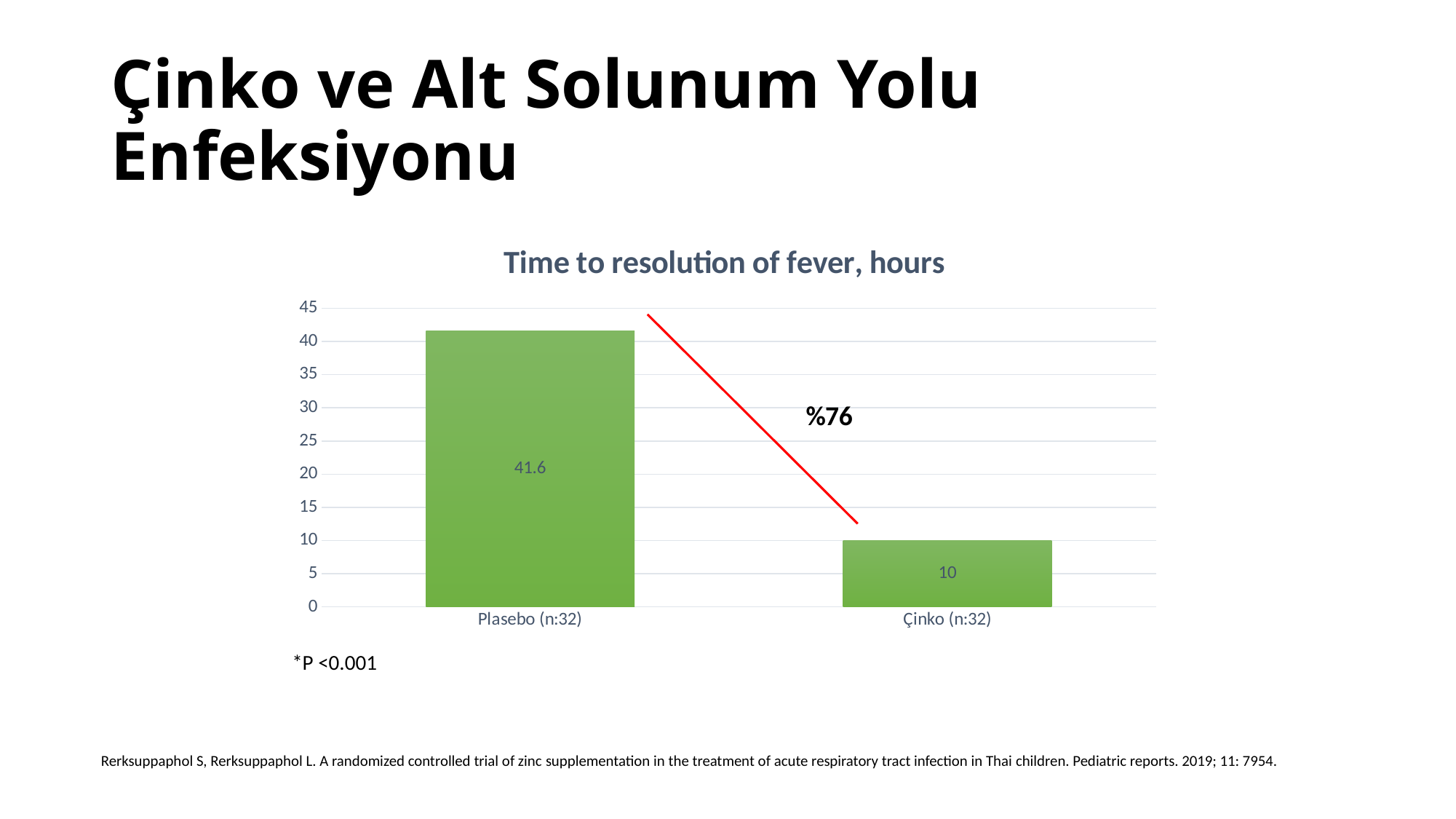
Is the value for Çinko (n:32) greater or less than 15? less How many categories are shown in the chart? 2 Which category has the lowest time to resolution of fever? Çinko (n:32) What is the title of the chart? Time to resolution of fever, hours What is the value for Çinko (n:32)? 10 What kind of chart is shown on the slide? Bar chart Is the value for Plasebo (n:32) greater or less than 40? greater What percentage reduction is annotated next to the red line on the chart? %76 Which is larger, the value for Plasebo (n:32) or Çinko (n:32)? Plasebo (n:32) Which category has the highest time to resolution of fever? Plasebo (n:32) What is the difference between the values for Plasebo (n:32) and Çinko (n:32)? 31.6 What is the value for Plasebo (n:32)? 41.6